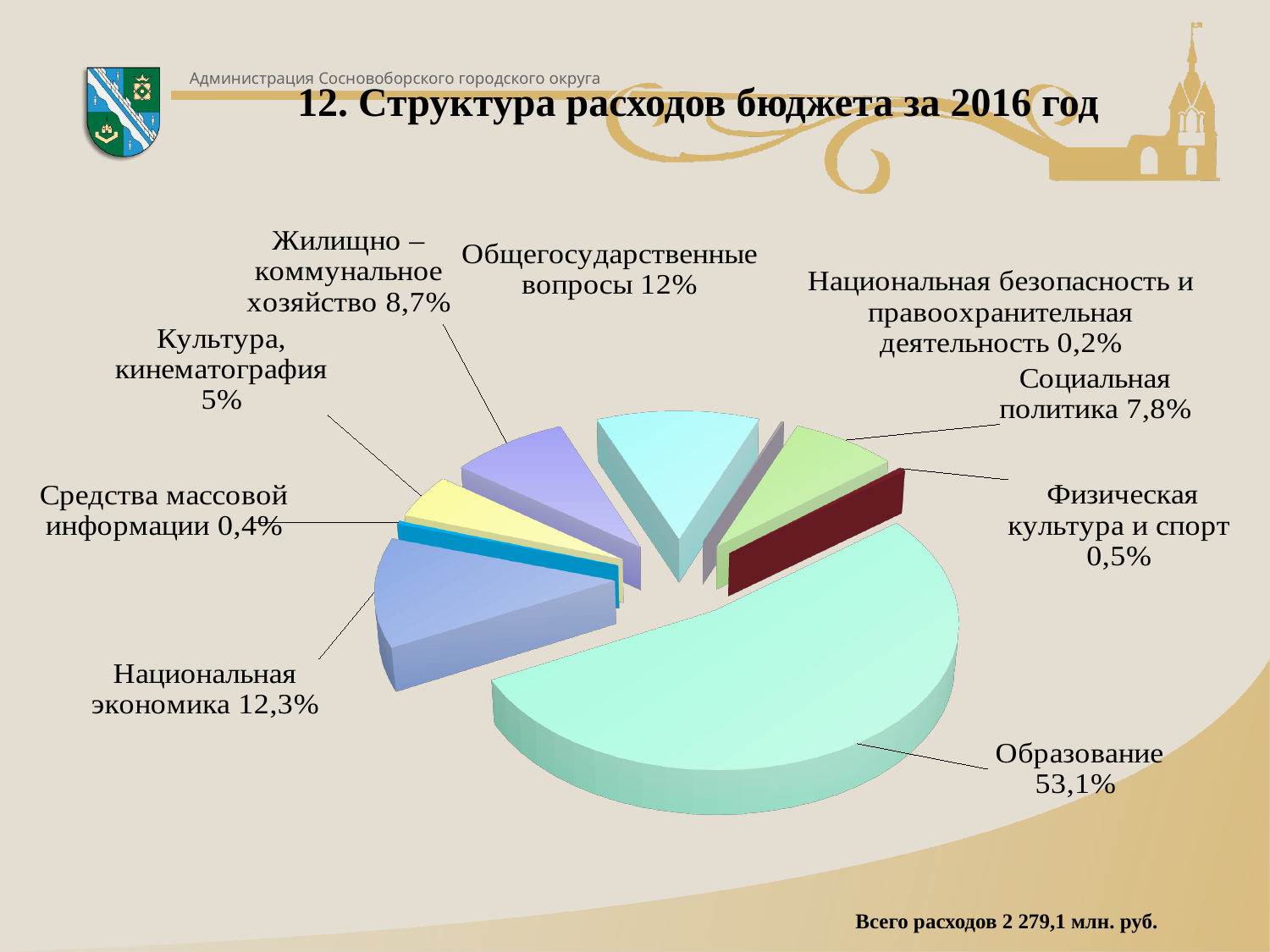
How many categories are shown in the pie chart? 9 What is the value for Социальная политика? 7,8% Which category has the smallest share of the budget expenditure? Национальная безопасность и правоохранительная деятельность What type of chart is shown on the slide? Pie chart What is the difference between the shares of Национальная экономика and Общегосударственные вопросы? 0,3% What is the difference between the shares of Жилищно-коммунальное хозяйство and Социальная политика? 0,9% Which is larger: Общегосударственные вопросы or Национальная экономика? Национальная экономика What is the total expenditure stated on the slide? 2 279,1 млн. руб. What share of the 2016 budget expenditure goes to Образование? 53,1% Which category has the largest share of the budget expenditure? Образование What is the value shown for Национальная экономика? 12,3% What percentage is shown for Жилищно-коммунальное хозяйство? 8,7%